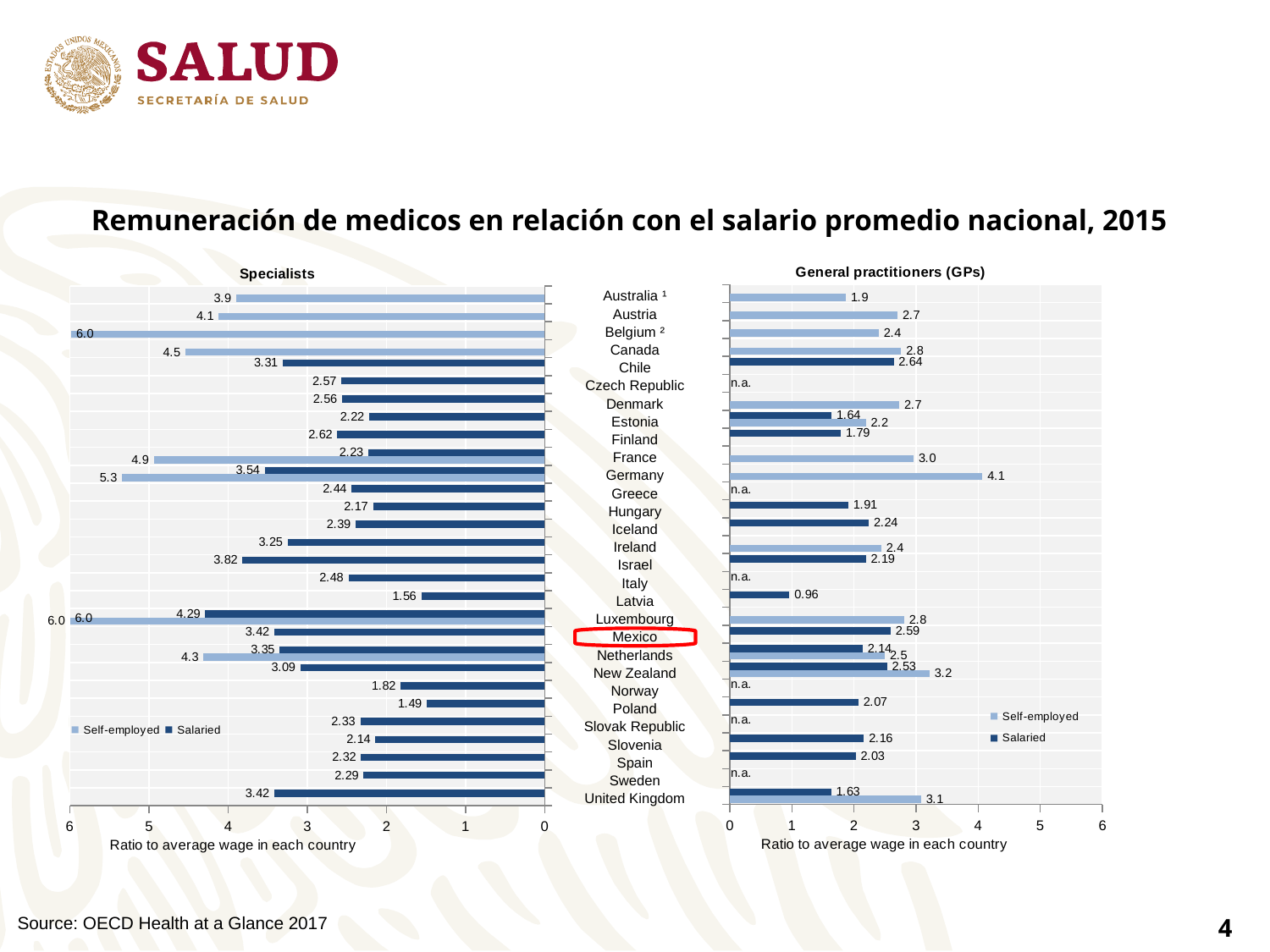
In the Specialists chart, which has the larger salaried value, Israel or Ireland? Israel Which country label is circled in red between the two charts? Mexico In the General practitioners (GPs) chart, what is the salaried value for the United Kingdom? 1.63 What kind of chart is the General practitioners (GPs) chart? Bar chart In the Specialists chart, what is the difference between the self-employed and salaried values for Germany? 1.76 In the Specialists chart, which country has the lowest salaried value? Poland How many series does the legend of the Specialists chart list? 2 In the Specialists chart, what is the self-employed value for Germany? 5.3 In the Specialists chart, what is the salaried value for Mexico? 3.42 In the General practitioners (GPs) chart, what is the salaried value for Mexico? 2.59 In the General practitioners (GPs) chart, which country has the highest self-employed value? Germany In the General practitioners (GPs) chart, what is the self-employed value for Germany? 4.1